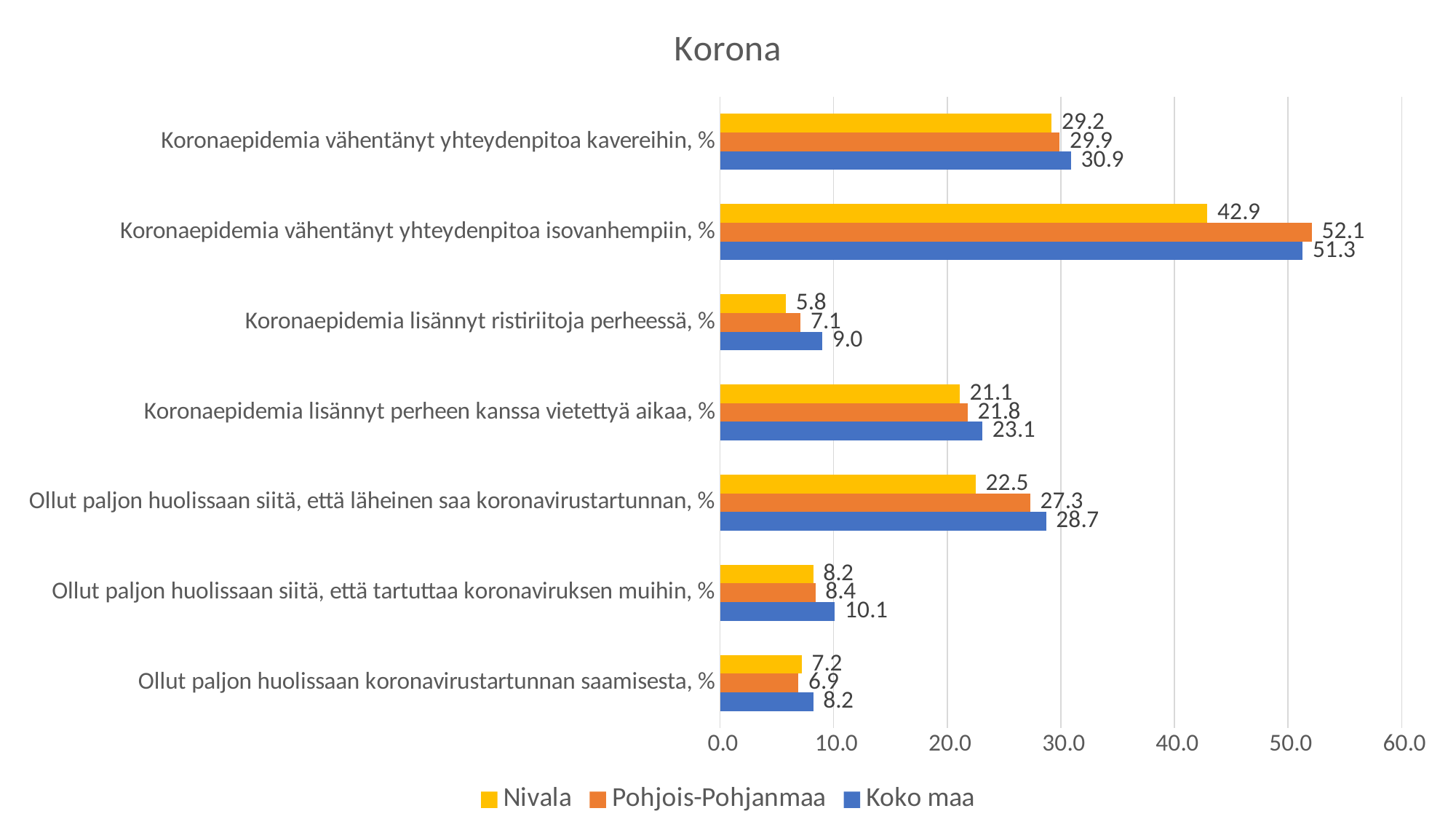
Is the Koko maa value for 'Koronaepidemia vähentänyt yhteydenpitoa kavereihin, %' greater or less than 30.0? greater Which category has the lowest value for Nivala? Koronaepidemia lisännyt ristiriitoja perheessä, % What is the difference between the Koko maa and Nivala values for 'Koronaepidemia vähentänyt yhteydenpitoa isovanhempiin, %'? 8.4 Which category has the highest value for Pohjois-Pohjanmaa? Koronaepidemia vähentänyt yhteydenpitoa isovanhempiin, % How many categories are shown on the chart? 7 What is the title of the chart? Korona What kind of chart is shown on the slide? bar chart What is the value for Koko maa for 'Koronaepidemia lisännyt ristiriitoja perheessä, %'? 9.0 For 'Ollut paljon huolissaan koronavirustartunnan saamisesta, %', which is larger: the Nivala value or the Pohjois-Pohjanmaa value? Nivala How many series does the legend list? 3 What is the value for Pohjois-Pohjanmaa for 'Ollut paljon huolissaan siitä, että läheinen saa koronavirustartunnan, %'? 27.3 What is the value for Nivala for 'Koronaepidemia vähentänyt yhteydenpitoa isovanhempiin, %'? 42.9